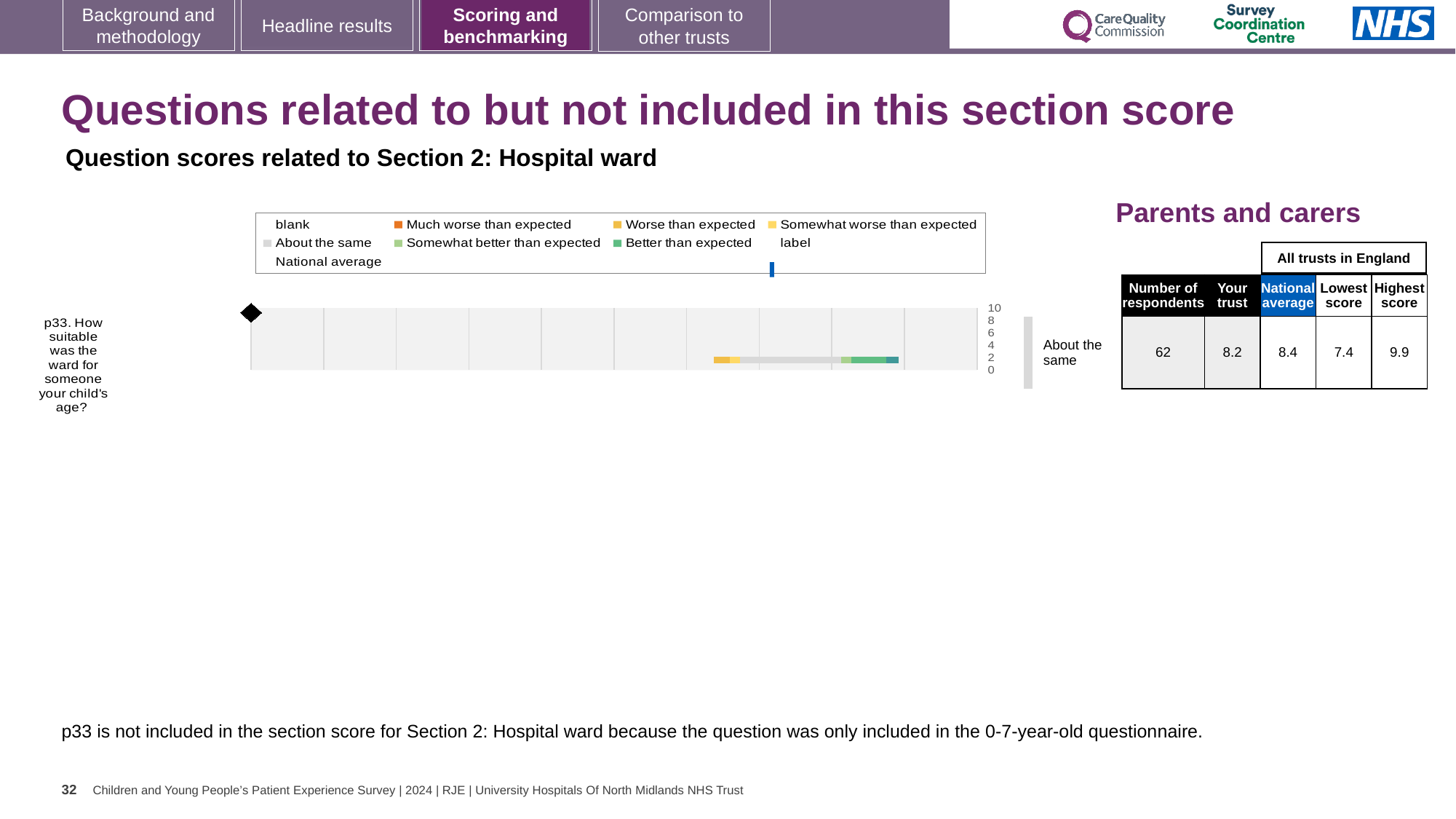
How many questions are plotted in the chart? 1 What is the highest score among all trusts in England for p33? 9.9 Which is larger for p33, the 'Your trust' score or the national average? National average What is the national average score for p33 in the Parents and carers table? 8.4 What kind of chart is used to show the p33 question score? bar chart How many entries does the chart legend list? 9 What is the lowest score among all trusts in England for p33? 7.4 Which question is plotted in the chart? p33. How suitable was the ward for someone your child's age? What is the 'Your trust' score for p33 in the Parents and carers table? 8.2 How many respondents answered p33 according to the table? 62 What is the difference between the highest score and the lowest score for p33? 2.5 What comparison label is shown to the right of the p33 bar? About the same